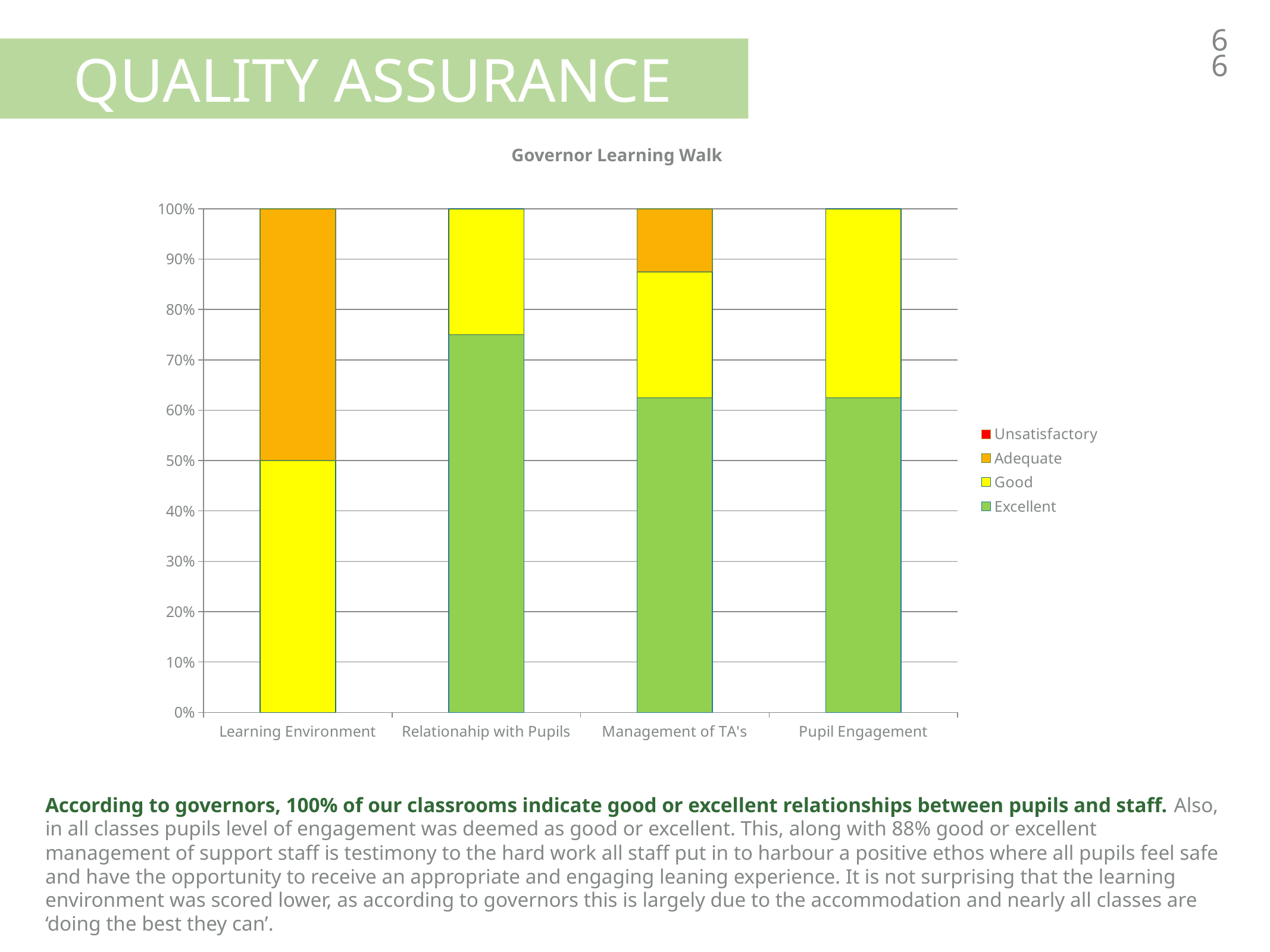
What is the title of the chart? Governor Learning Walk Which category has no Excellent segment in its bar? Learning Environment How many categories are shown on the x axis of the chart? 4 Which category has the largest Excellent share? Relationahip with Pupils Is the Excellent share for Pupil Engagement greater or less than 60%? greater What is the Good share for Learning Environment? 50% Is the Excellent share for Relationahip with Pupils greater or less than 70%? greater Which category has the largest Adequate share? Learning Environment What type of chart is shown on the slide? Stacked bar chart Is the Adequate share for Management of TA's greater or less than 20%? less Which has the larger Excellent share: Relationahip with Pupils or Pupil Engagement? Relationahip with Pupils How many series does the chart legend list? 4